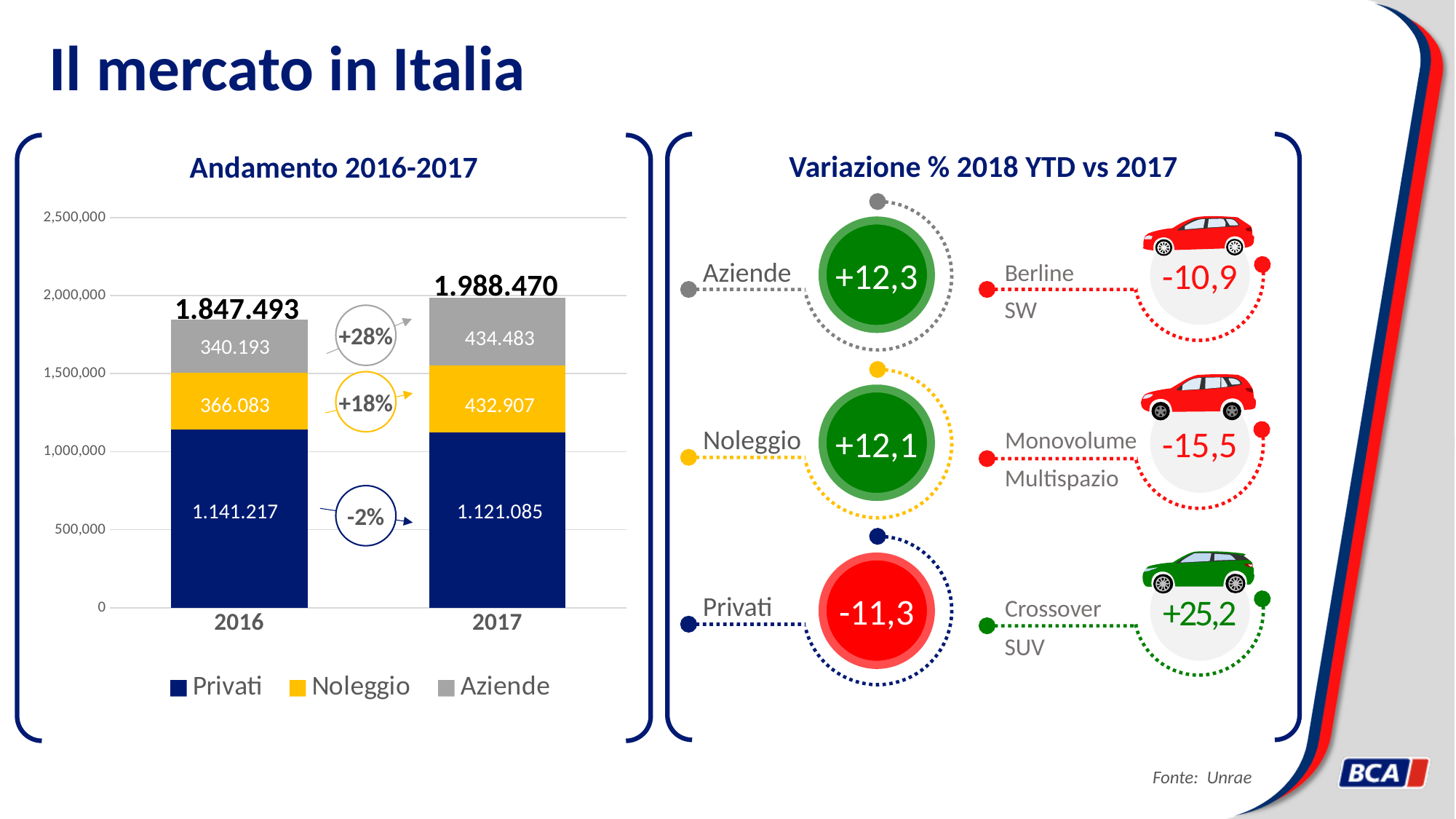
In the 'Andamento 2016-2017' chart, which series is the largest segment in the 2017 bar? Privati In the 'Andamento 2016-2017' chart, what is the value for Noleggio in 2016? 366.083 What kind of chart is 'Andamento 2016-2017'? Stacked bar chart In the 'Andamento 2016-2017' chart, is the Privati value larger in 2016 or in 2017? 2016 In the 'Andamento 2016-2017' chart, what is the total of the 2016 stacked bar? 1.847.493 In the 'Andamento 2016-2017' chart, what is the value for Aziende in 2017? 434.483 In the 'Andamento 2016-2017' chart, how many years are shown on the x axis? 2 In the 'Andamento 2016-2017' chart, what is the value for Privati in 2016? 1.141.217 In the 'Andamento 2016-2017' chart, by how much did Aziende increase from 2016 to 2017? 94.290 In the 'Andamento 2016-2017' chart, how many series does the legend list? 3 In the 'Andamento 2016-2017' chart, what is the total of the 2017 stacked bar? 1.988.470 In the 'Andamento 2016-2017' chart, is the total for 2017 greater or less than 1,500,000? greater